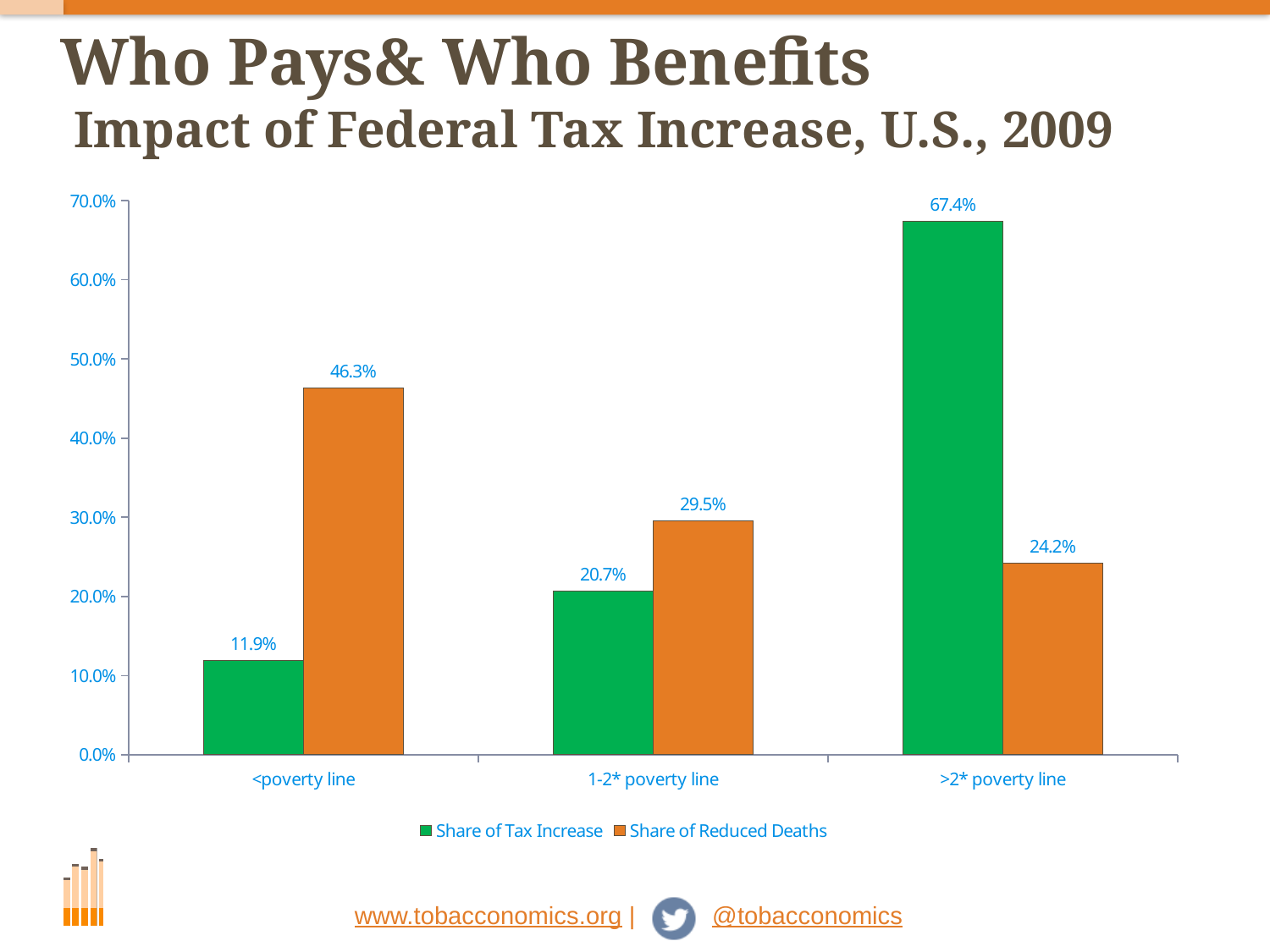
What is the Share of Tax Increase for the <poverty line group? 11.9% What kind of chart is shown on the slide? bar chart How many income groups are shown on the x axis? 3 What is the difference between the Share of Tax Increase and the Share of Reduced Deaths for the >2* poverty line group? 43.2% Which income group has the lowest Share of Tax Increase? <poverty line What is the Share of Tax Increase for the >2* poverty line group? 67.4% How many series does the legend list? 2 For the <poverty line group, which is larger: Share of Tax Increase or Share of Reduced Deaths? Share of Reduced Deaths Does the Share of Tax Increase rise or fall as income group moves from <poverty line to >2* poverty line? rise Is the Share of Reduced Deaths for the >2* poverty line group greater or less than 30.0%? less Which income group has the highest Share of Reduced Deaths? <poverty line What is the Share of Reduced Deaths for the 1-2* poverty line group? 29.5%